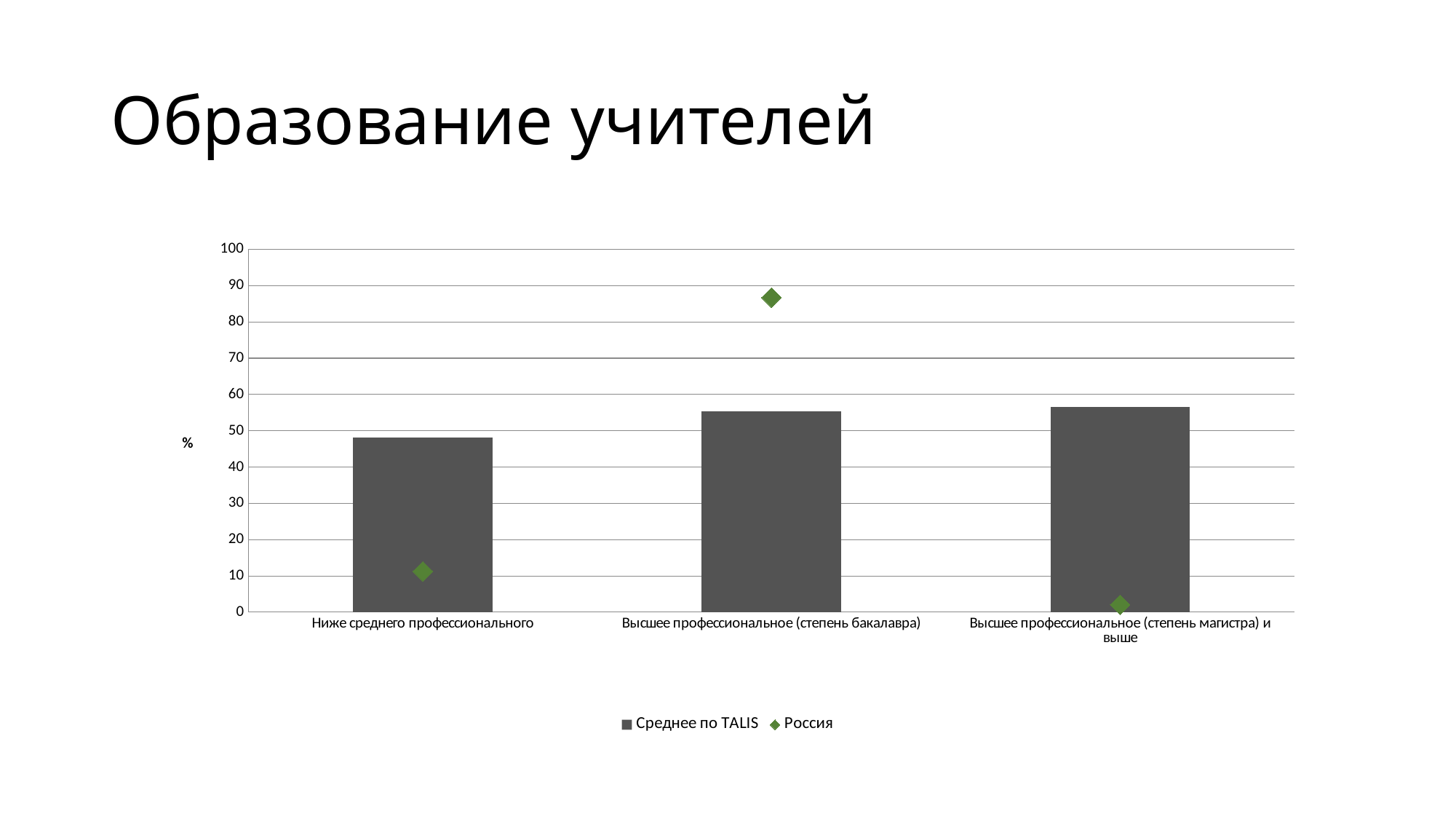
Which category has the highest value for the series Россия? Высшее профессиональное (степень бакалавра) What kind of chart is shown on the slide? bar chart Which category has the lowest value for the series Среднее по TALIS? Ниже среднего профессионального In the category Высшее профессиональное (степень бакалавра), which series has the larger value: Среднее по TALIS or Россия? Россия Which category has the lowest value for the series Россия? Высшее профессиональное (степень магистра) и выше Is the value for Россия in the category Высшее профессиональное (степень бакалавра) greater or less than 80? greater In the category Высшее профессиональное (степень магистра) и выше, which series has the larger value: Среднее по TALIS or Россия? Среднее по TALIS Is the value for Среднее по TALIS in the category Ниже среднего профессионального greater or less than 40? greater How many categories are shown on the x axis of the chart? 3 What is the title of the slide containing the chart? Образование учителей How many series does the chart legend list? 2 Is the value for Россия in the category Ниже среднего профессионального greater or less than 20? less